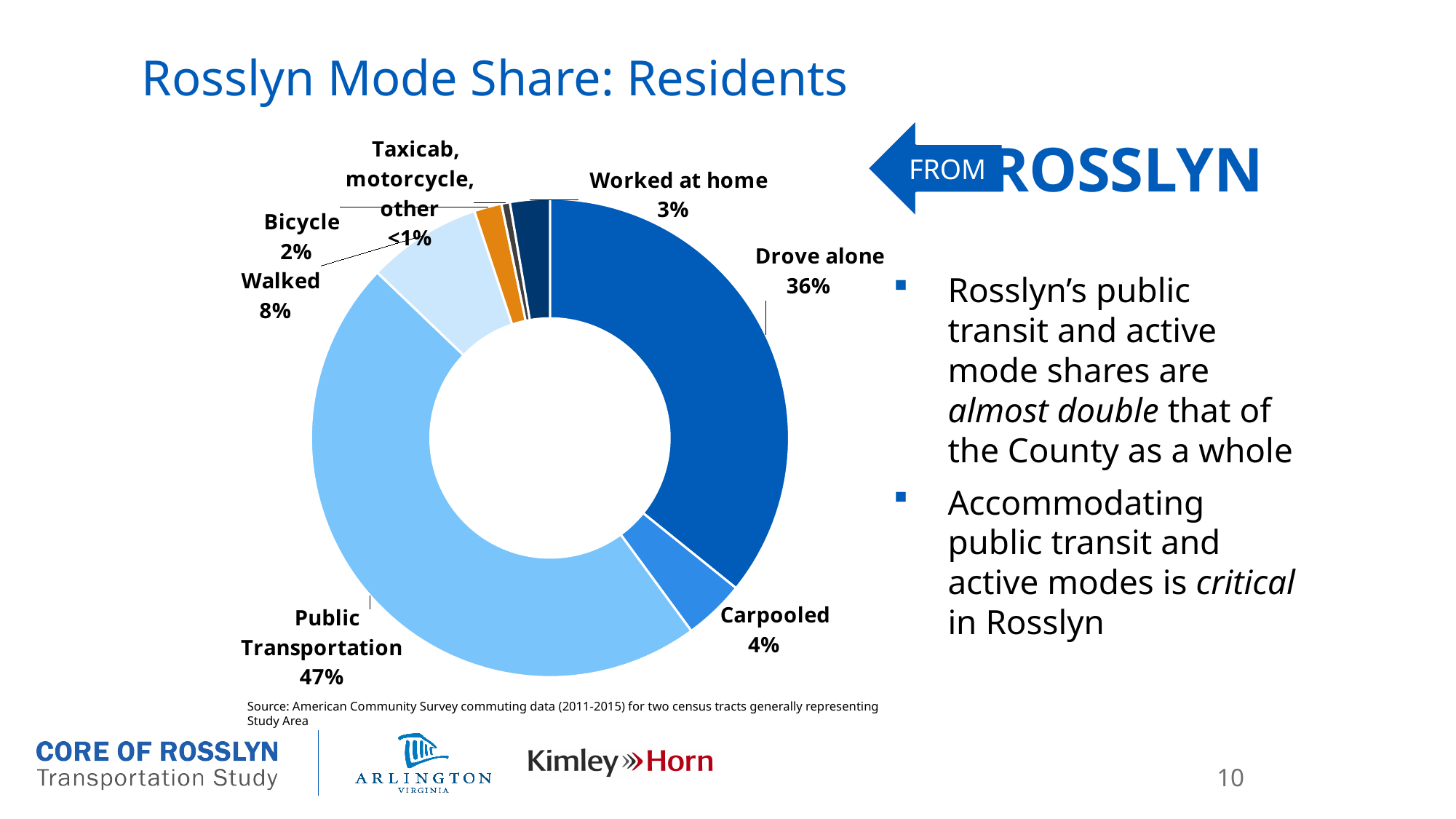
What is the title of the slide containing the chart? Rosslyn Mode Share: Residents Which mode has the largest share in the chart? Public Transportation What share is shown for Taxicab, motorcycle, other? <1% What type of chart is used on this slide? Donut (pie) chart What is the share for Carpooled? 4% Which is larger, the share for Walked or the share for Worked at home? Walked What percentage of residents walked? 8% How many percentage points higher is Public Transportation than Drove alone? 11 Which mode has the smallest share in the chart? Taxicab, motorcycle, other What is the mode share for Public Transportation? 47% What share of Rosslyn residents drove alone? 36% How many mode categories are shown in the chart? 7